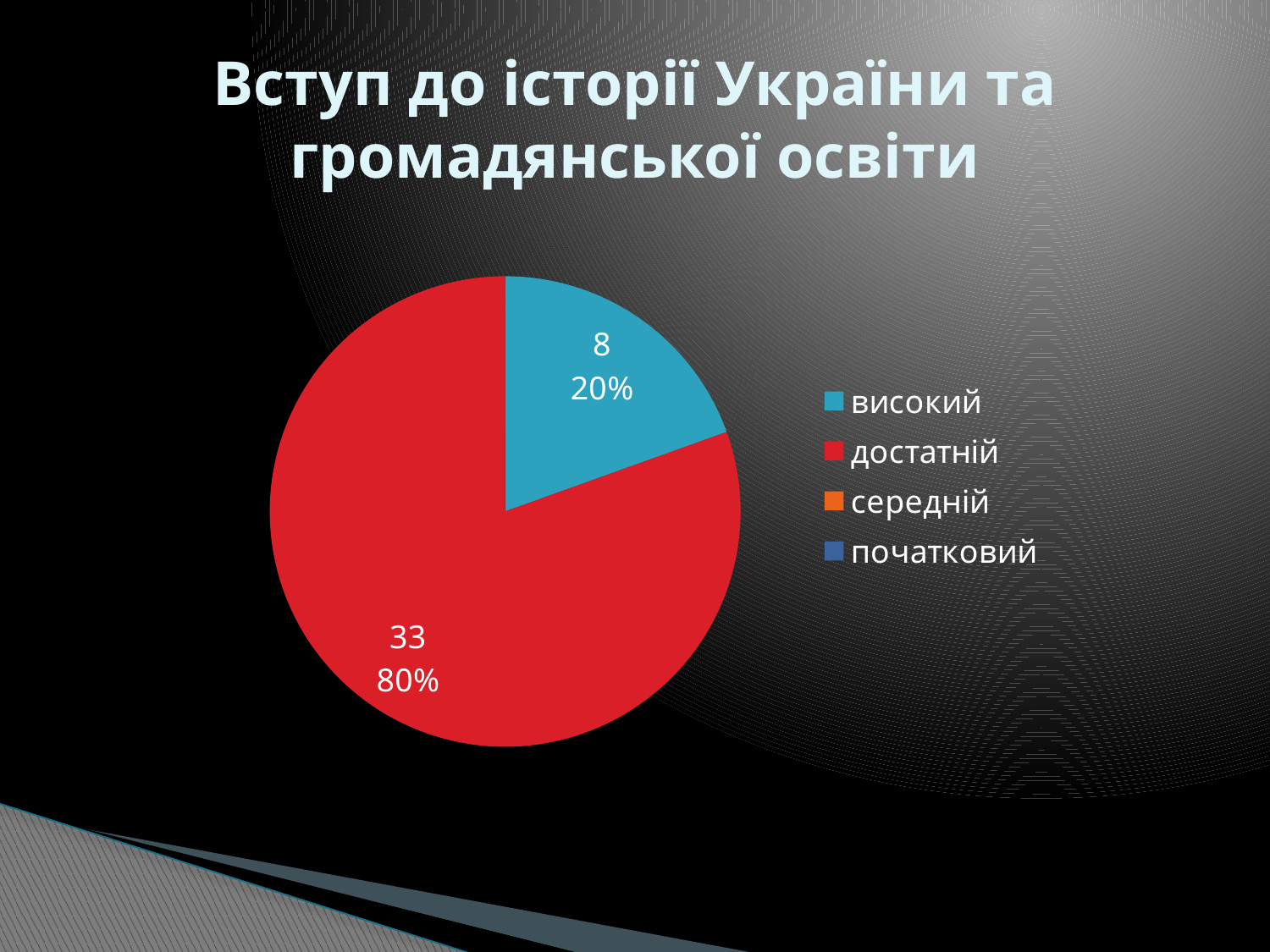
What percentage share of the pie does the "високий" slice have? 20% How many slices with labelled values are visible in the pie chart? 2 Which category has the largest slice in the pie chart? достатній What percentage share of the pie does the "достатній" slice have? 80% What is the total of the values labelled on the pie chart? 41 What colour is the "достатній" slice in the pie chart? red Which is larger, the "високий" slice or the "достатній" slice? достатній What value is shown for the "достатній" slice of the pie chart? 33 What value is shown for the "високий" slice of the pie chart? 8 What is the difference between the values for "достатній" and "високий"? 25 How many categories does the legend of the pie chart list? 4 What kind of chart is shown on the slide? pie chart